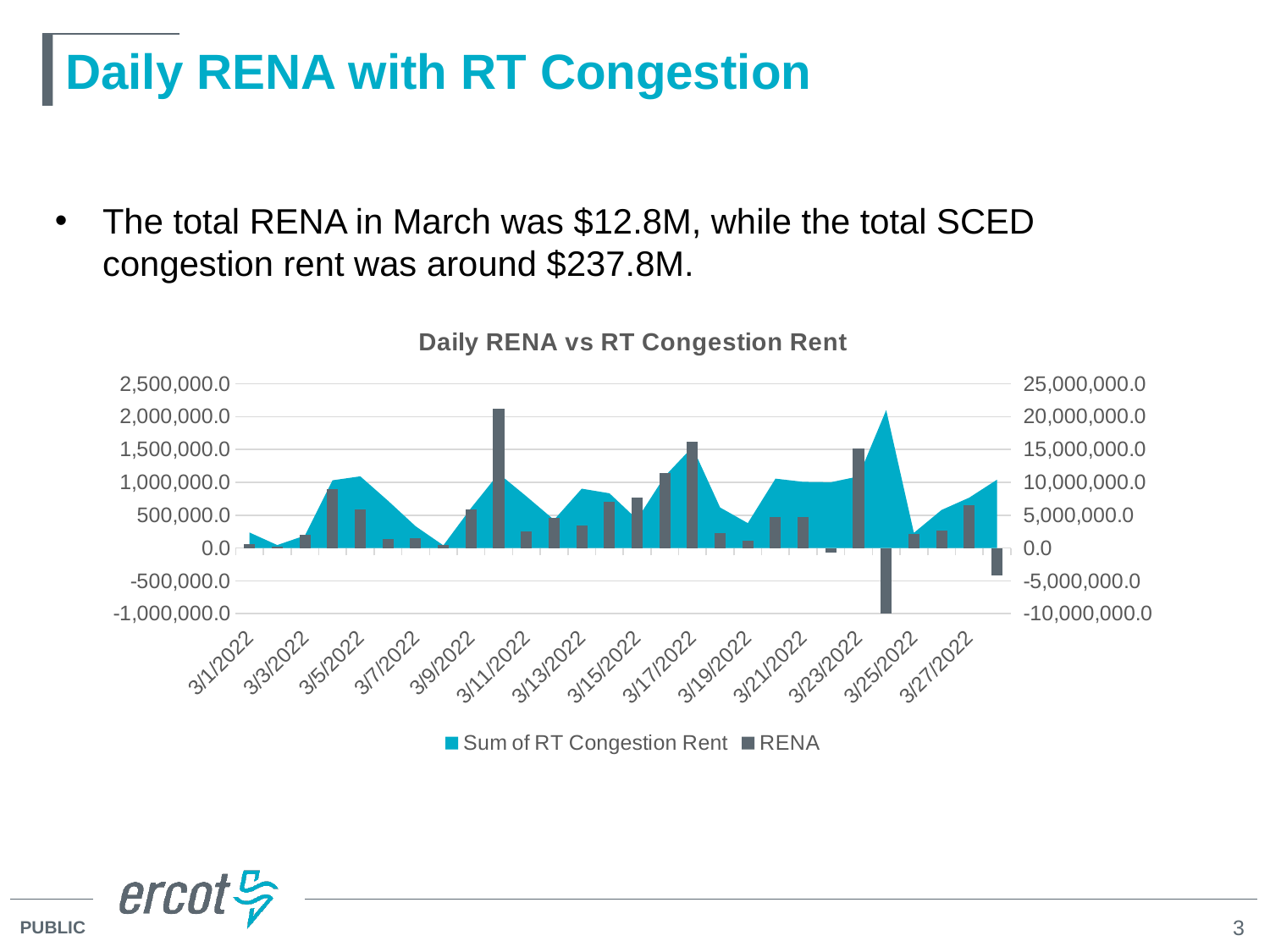
What are the two series named in the chart legend? Sum of RT Congestion Rent and RENA Is the Sum of RT Congestion Rent for 3/1/2022 greater or less than 5,000,000.0? less Which date has the larger RENA value, 3/17/2022 or 3/19/2022? 3/17/2022 Is the RENA value for 3/1/2022 greater or less than 500,000.0? less Is the RENA value for 3/19/2022 greater or less than 500,000.0? less What kind of chart is used to plot the RENA series? bar chart What is the title of the chart on the slide? Daily RENA vs RT Congestion Rent How many date labels are shown on the x axis of the chart? 14 How many series does the legend list in the Daily RENA vs RT Congestion Rent chart? 2